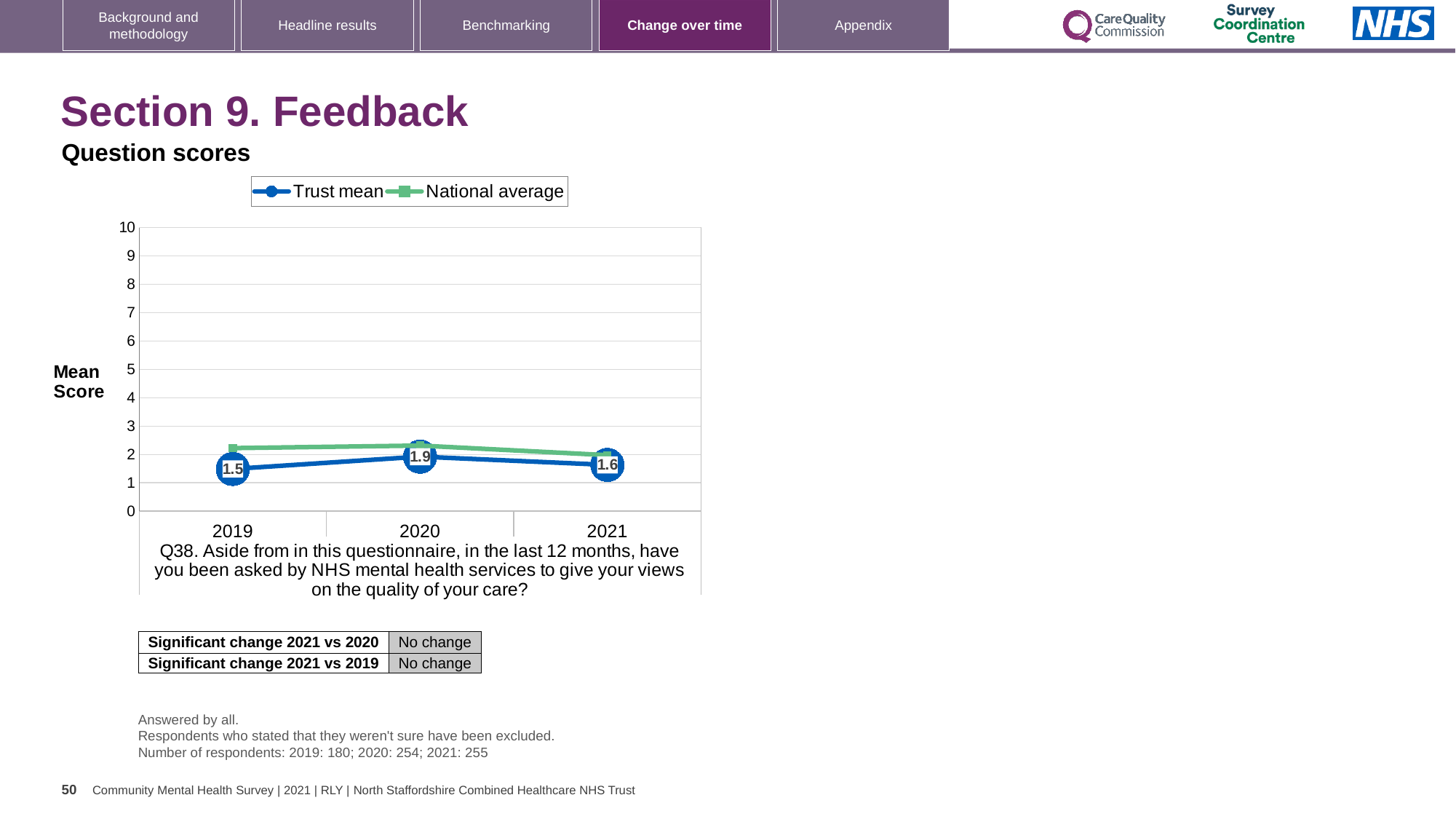
In which year is the Trust mean score highest? 2020 In which year is the Trust mean score lowest? 2019 How many years are plotted on the x axis? 3 What is the Trust mean score for 2021? 1.6 In 2019, which is larger: the Trust mean or the National average? National average What is the Trust mean score for 2020? 1.9 What kind of chart is shown on the slide? Line chart What is the Trust mean score for 2019? 1.5 How many series does the legend list? 2 What is the difference between the Trust mean score in 2020 and in 2019? 0.4 Does the Trust mean score rise or fall from 2020 to 2021? Fall Is the National average value for 2020 greater or less than 2? greater